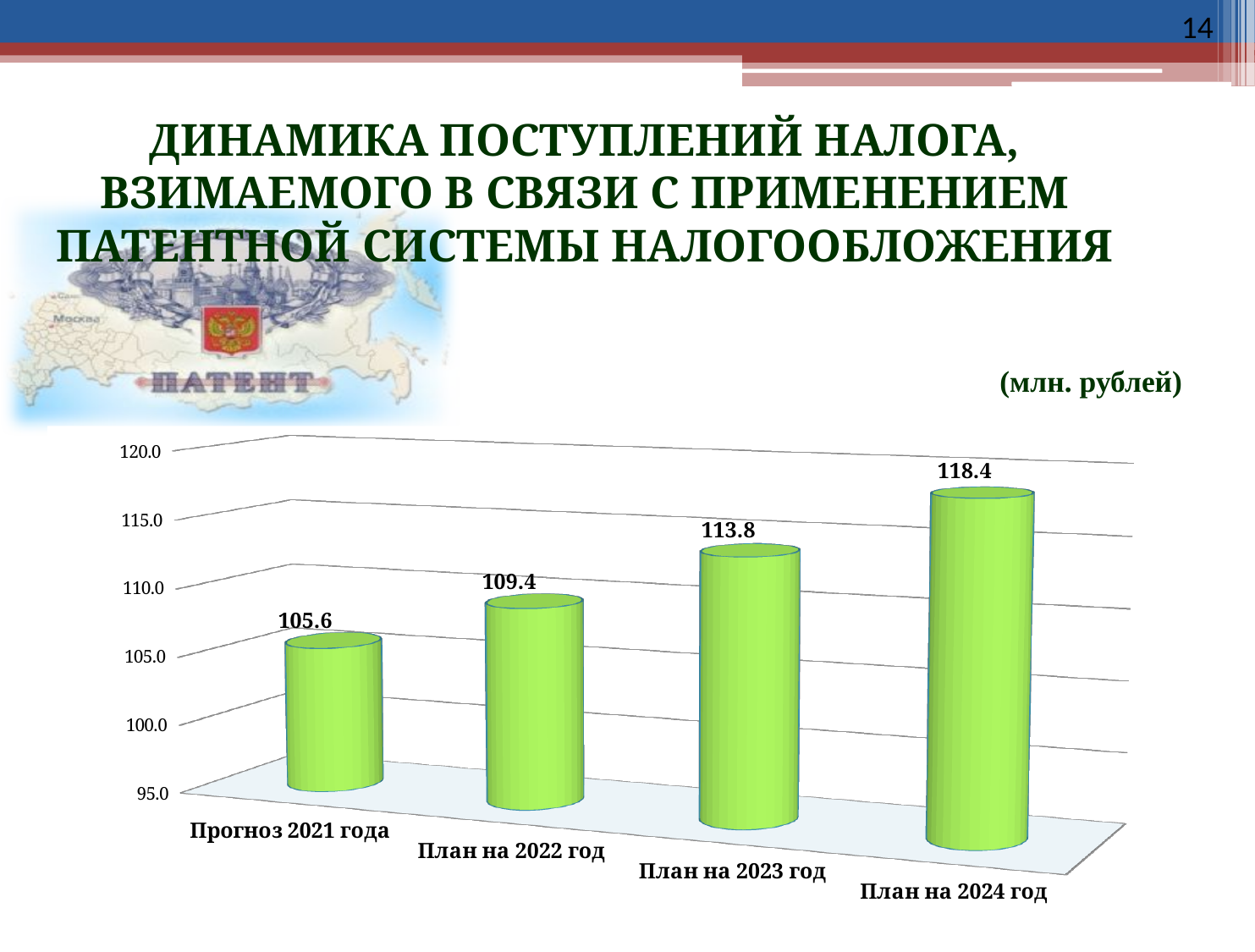
Which is larger, the value for План на 2022 год or the value for План на 2023 год? План на 2023 год What is the difference between the values for План на 2023 год and План на 2022 год? 4.4 How many categories are shown on the chart? 4 What is the value for План на 2024 год? 118.4 Which category has the lowest value? Прогноз 2021 года What is the value for План на 2022 год? 109.4 What kind of chart is shown on the slide? bar chart What is the value for Прогноз 2021 года? 105.6 What is the value for План на 2023 год? 113.8 What is the difference between the values for План на 2024 год and Прогноз 2021 года? 12.8 Which category has the highest value? План на 2024 год Do the values rise or fall from Прогноз 2021 года to План на 2024 год? rise